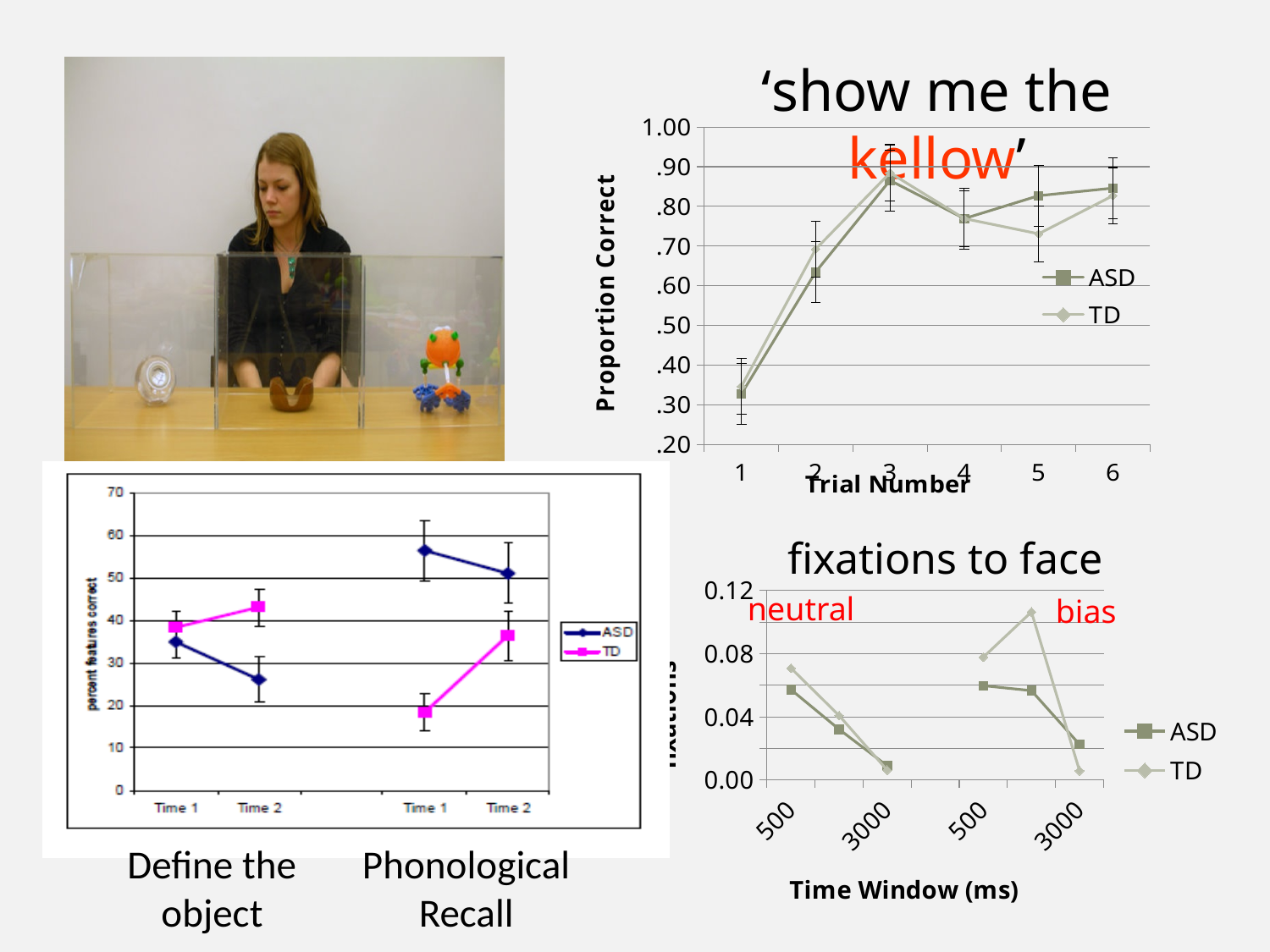
In the 'show me the kellow' chart, how many series does the legend list? 2 In the 'fixations to face' chart, what is the title of the x axis? Time Window (ms) In the 'show me the kellow' chart, which series has the higher value at trial 5, ASD or TD? ASD In the 'show me the kellow' chart, how many trial numbers are shown on the x axis? 6 In the 'show me the kellow' chart, is the TD value at trial 3 greater or less than .80? greater In the 'show me the kellow' chart, does proportion correct rise or fall from trial 1 to trial 3? rise In the 'show me the kellow' chart, is the ASD value at trial 1 greater or less than .40? less In the 'fixations to face' chart, do the values in the neutral condition rise or fall from 500 to 3000 ms? fall In the bottom-left chart, is the ASD value at Time 1 for Phonological Recall greater or less than 50? greater In the bottom-left chart, which series has the higher value at Time 1 for Phonological Recall, ASD or TD? ASD What type of chart is the 'show me the kellow' chart at the top right? line chart